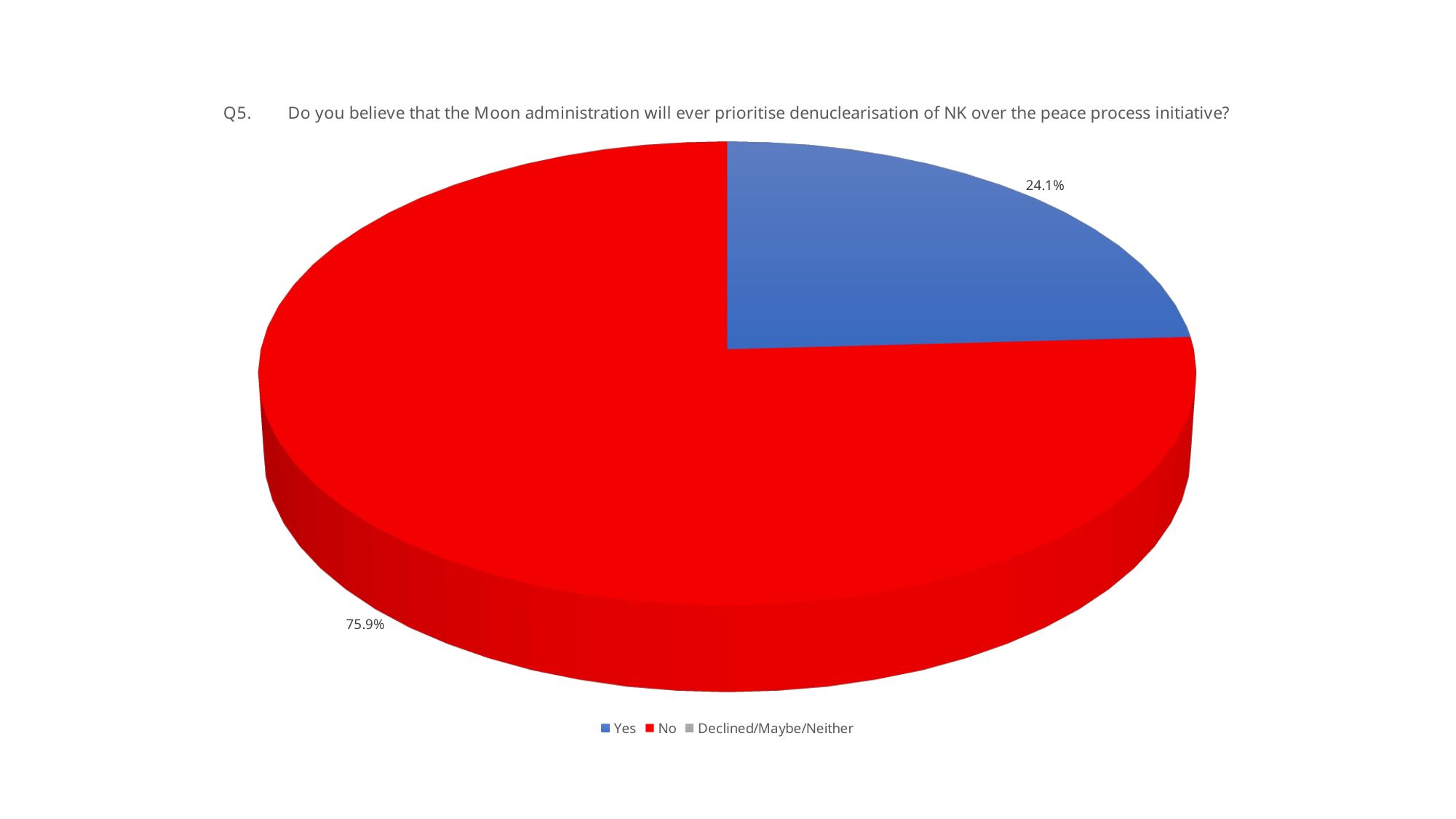
What is the difference in percentage points between the "No" and "Yes" slices? 51.8 What kind of chart is shown on the slide? pie chart How many entries does the legend list? 3 What share of the pie does the "Yes" slice represent? 24.1% What colour is the "No" slice? red Which of the two labelled slices is larger, "Yes" or "No"? No What share of the pie does the "No" slice represent? 75.9% What colour is the "Yes" slice? blue Which response has the largest slice of the pie? No How many slices have a percentage label printed on the chart? 2